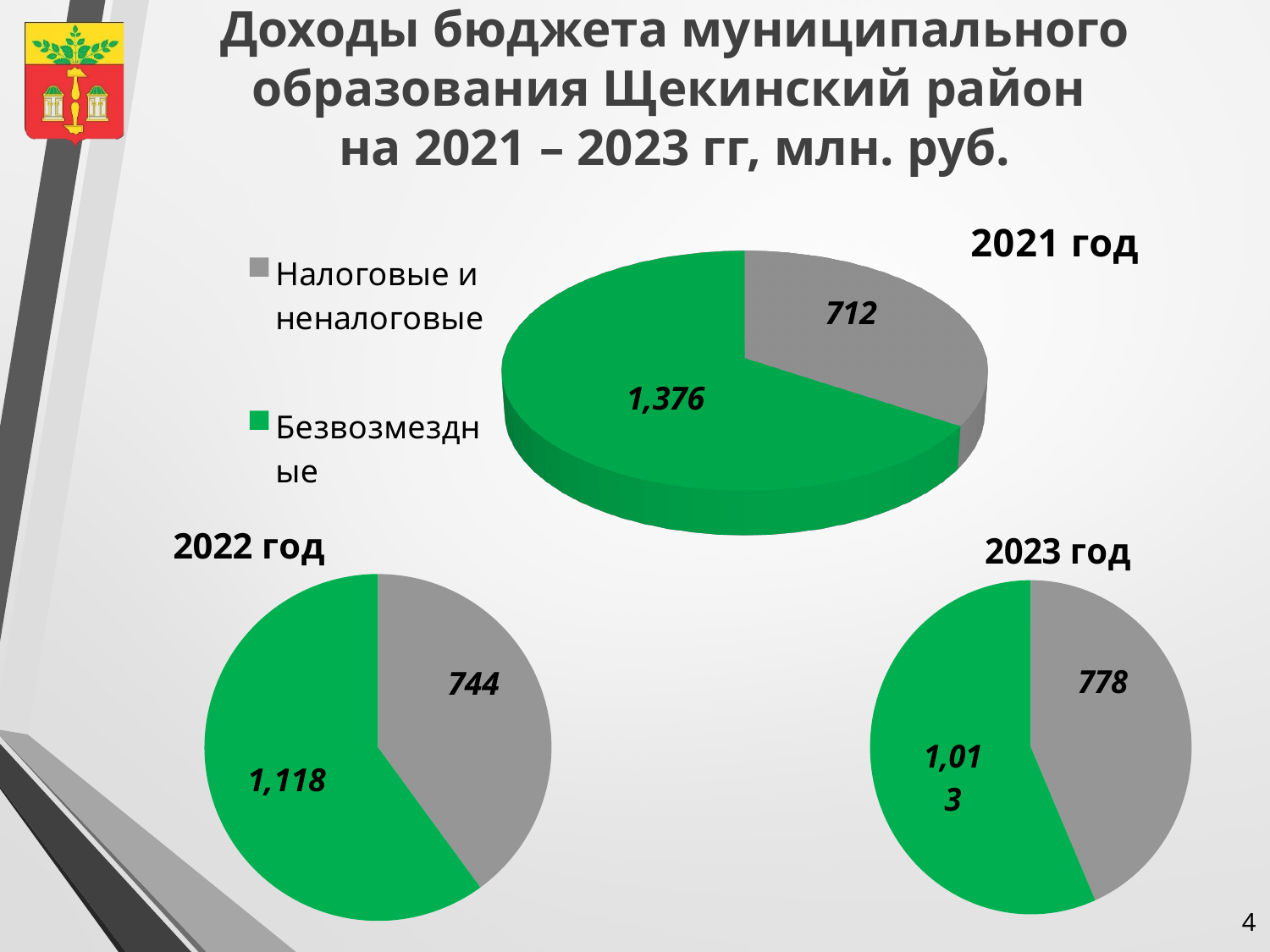
In the 2021 год pie chart, what is the difference between Безвозмездные and Налоговые и неналоговые? 664 What is the total of the two slices in the 2022 год pie chart? 1,862 In the 2021 год pie chart, what is the value for Безвозмездные? 1,376 In the 2023 год pie chart, what is the difference between Безвозмездные and Налоговые и неналоговые? 235 In the 2023 год pie chart, which category has the larger value? Безвозмездные How many pie charts are shown on the slide? 3 In the 2022 год pie chart, which category has the smaller value? Налоговые и неналоговые What type of chart is used to show the 2021 год data? Pie chart In the 2023 год pie chart, what is the value for Налоговые и неналоговые? 778 Is the value for Налоговые и неналоговые larger in the 2022 год chart or the 2023 год chart? 2023 год In the 2021 год pie chart, what is the value for Налоговые и неналоговые? 712 In the 2022 год pie chart, what is the value for Безвозмездные? 1,118